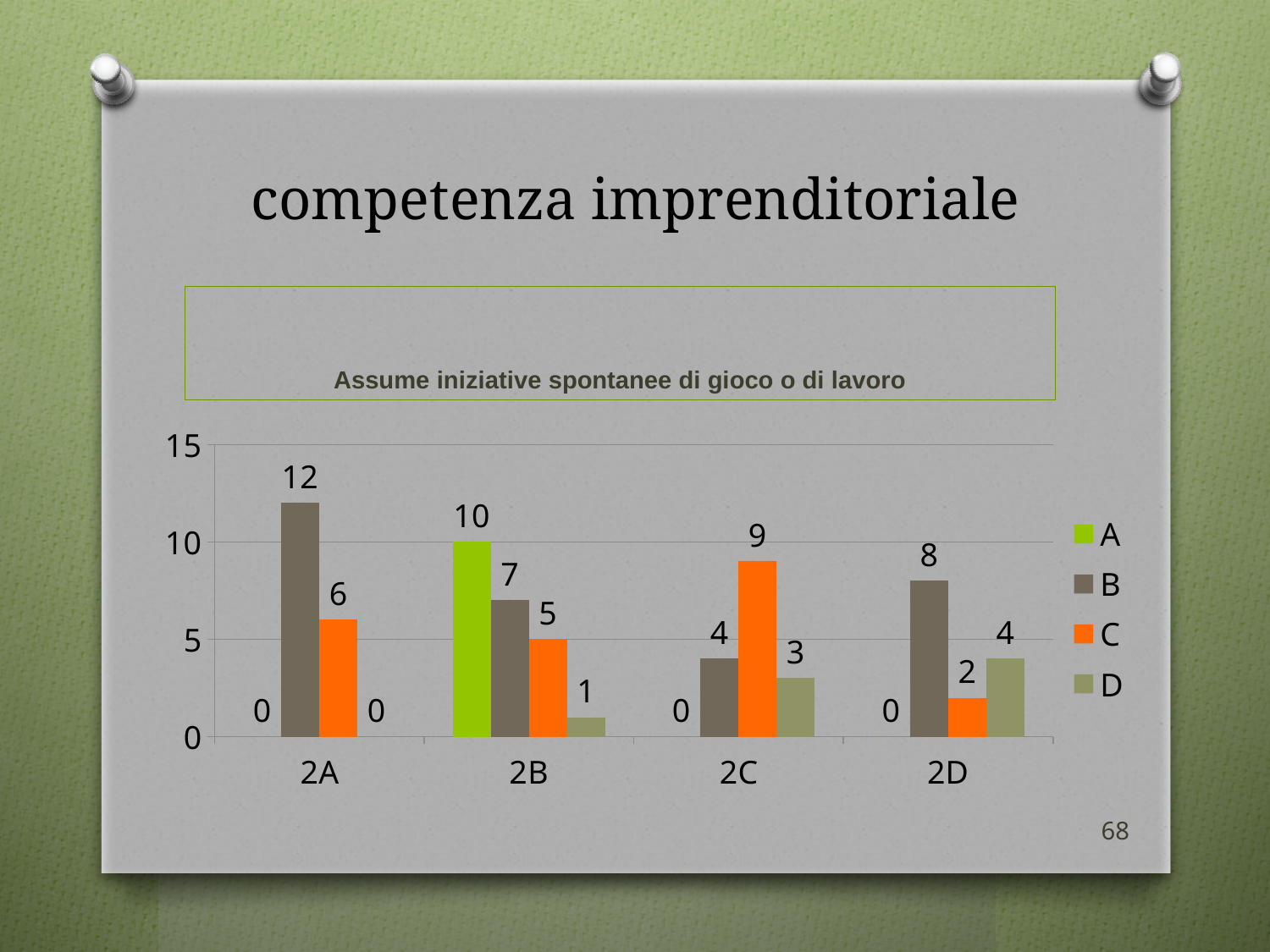
Which category has the highest value for series B? 2A What is the value of series C for category 2C? 9 How many series does the legend list? 4 What is the difference between the series B value for 2A and the series B value for 2D? 4 What is the value of series D for category 2D? 4 What is the title of the chart? Assume iniziative spontanee di gioco o di lavoro How many categories are shown on the x axis? 4 Which category has the lowest value for series C? 2D What is the value of series B for category 2A? 12 What kind of chart is shown on the slide? bar chart What is the value of series A for category 2B? 10 Which is larger for category 2C: the value of series B or the value of series C? series C